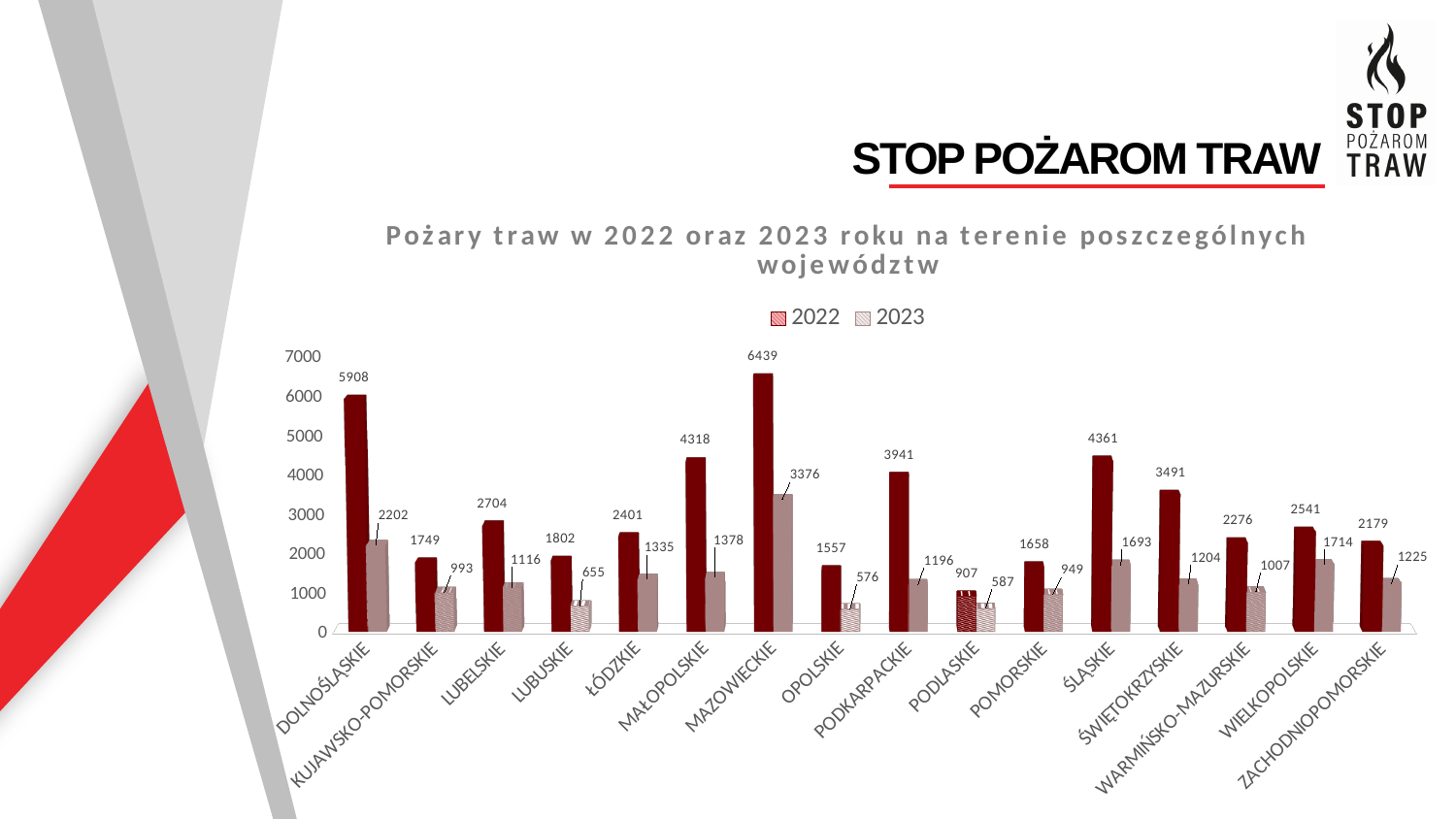
What is the value for ŚLĄSKIE in 2023? 1693 What is the value for MAZOWIECKIE in 2022? 6439 How many voivodeships (categories) are shown on the x axis? 16 Which is larger: the 2022 value for PODKARPACKIE or the 2022 value for ŚWIĘTOKRZYSKIE? PODKARPACKIE How many series does the legend list? 2 What type of chart is shown on the slide? bar chart What is the difference between the 2022 and 2023 values for DOLNOŚLĄSKIE? 3706 What are the two series listed in the legend? 2022 and 2023 Which voivodeship has the highest value in 2022? MAZOWIECKIE What is the value for PODLASKIE in 2022? 907 Is the 2022 value for MAŁOPOLSKIE greater or less than 4000? greater Which voivodeship has the lowest value in 2023? OPOLSKIE